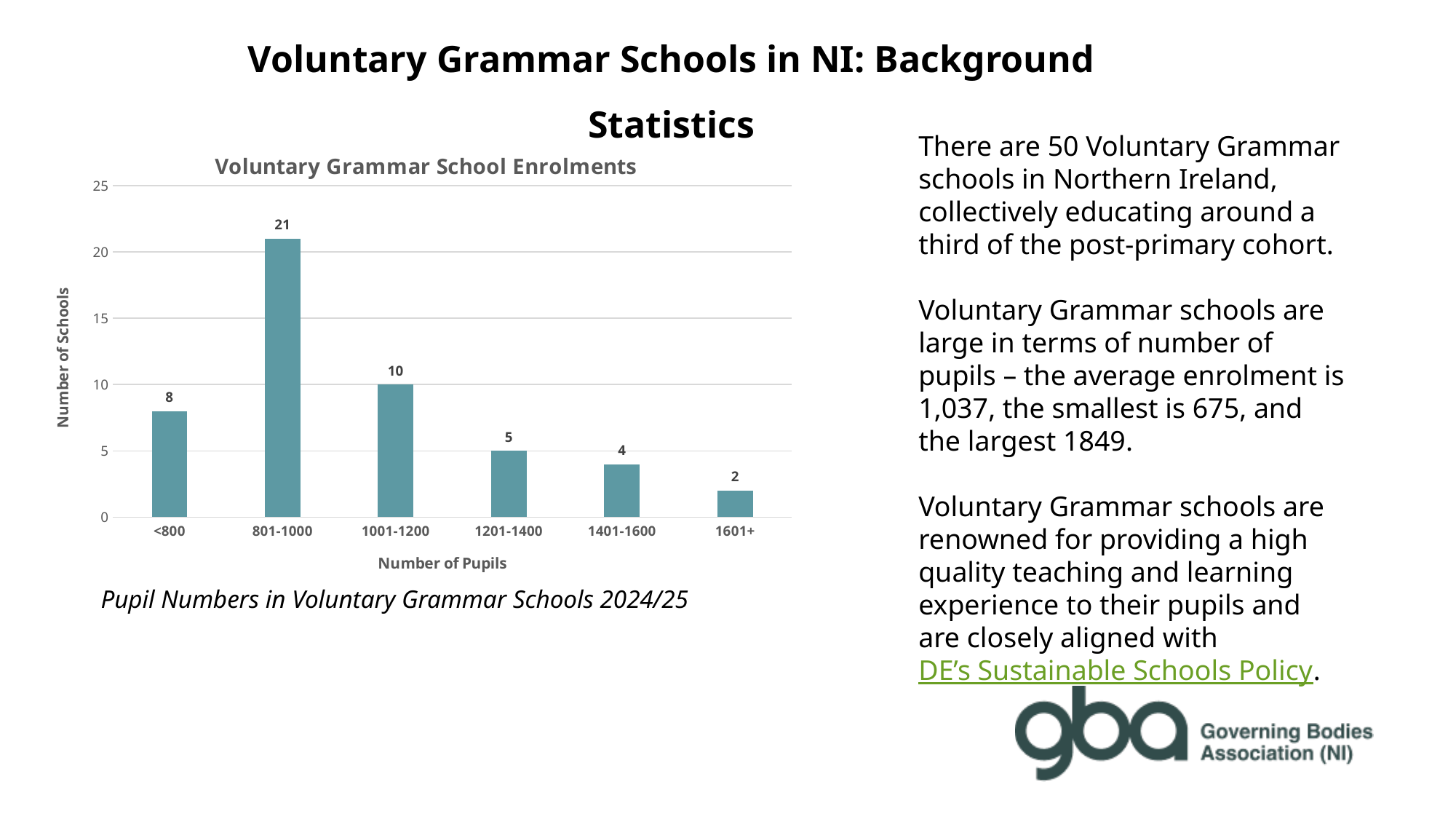
What is the difference between the number of schools in the 801-1000 category and the 1001-1200 category? 11 Which enrolment category has the highest number of schools? 801-1000 What is the number of schools in the <800 pupils category? 8 Which has more schools: the <800 category or the 1201-1400 category? <800 What is the title of the chart? Voluntary Grammar School Enrolments Do the values rise or fall along the x axis from 801-1000 to 1601+? Fall Is the value for the 1001-1200 category greater or less than 5? greater How many schools fall in the 1401-1600 pupils category? 4 How many schools have enrolments of 801-1000 pupils? 21 Which enrolment category has the lowest number of schools? 1601+ What kind of chart is shown on the slide? Bar chart How many enrolment categories are shown on the x axis? 6